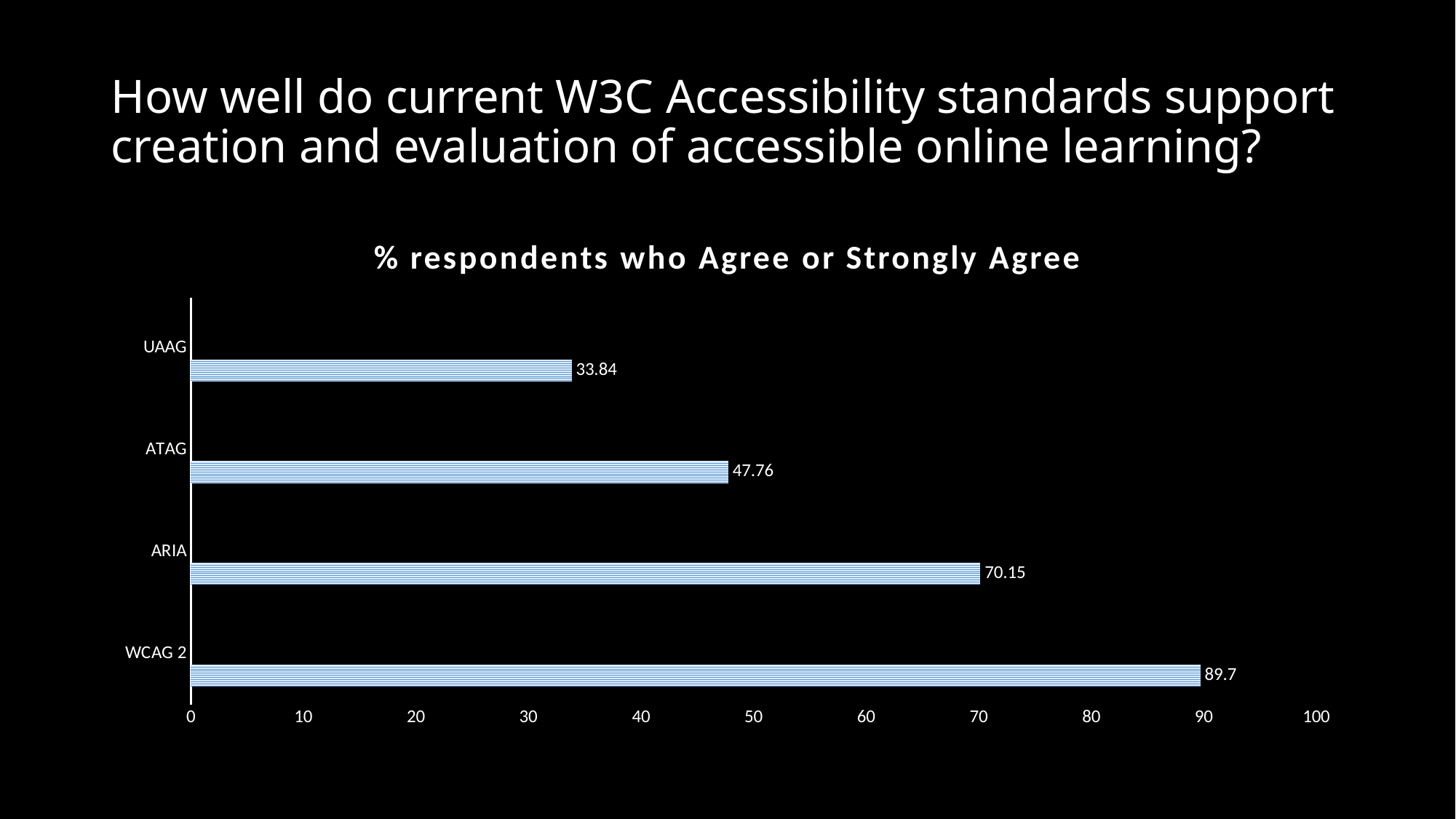
What is the value for UAAG? 33.84 How many categories are shown in the chart? 4 What is the value for ARIA? 70.15 What is the value for ATAG? 47.76 Which is larger, the value for ARIA or the value for ATAG? ARIA Which category has the lowest value? UAAG What kind of chart is shown on the slide? Bar chart What is the title of the chart? % respondents who Agree or Strongly Agree What is the difference between the values for WCAG 2 and ARIA? 19.55 Which category has the highest value? WCAG 2 What is the value for WCAG 2? 89.7 What is the difference between the values for ATAG and UAAG? 13.92